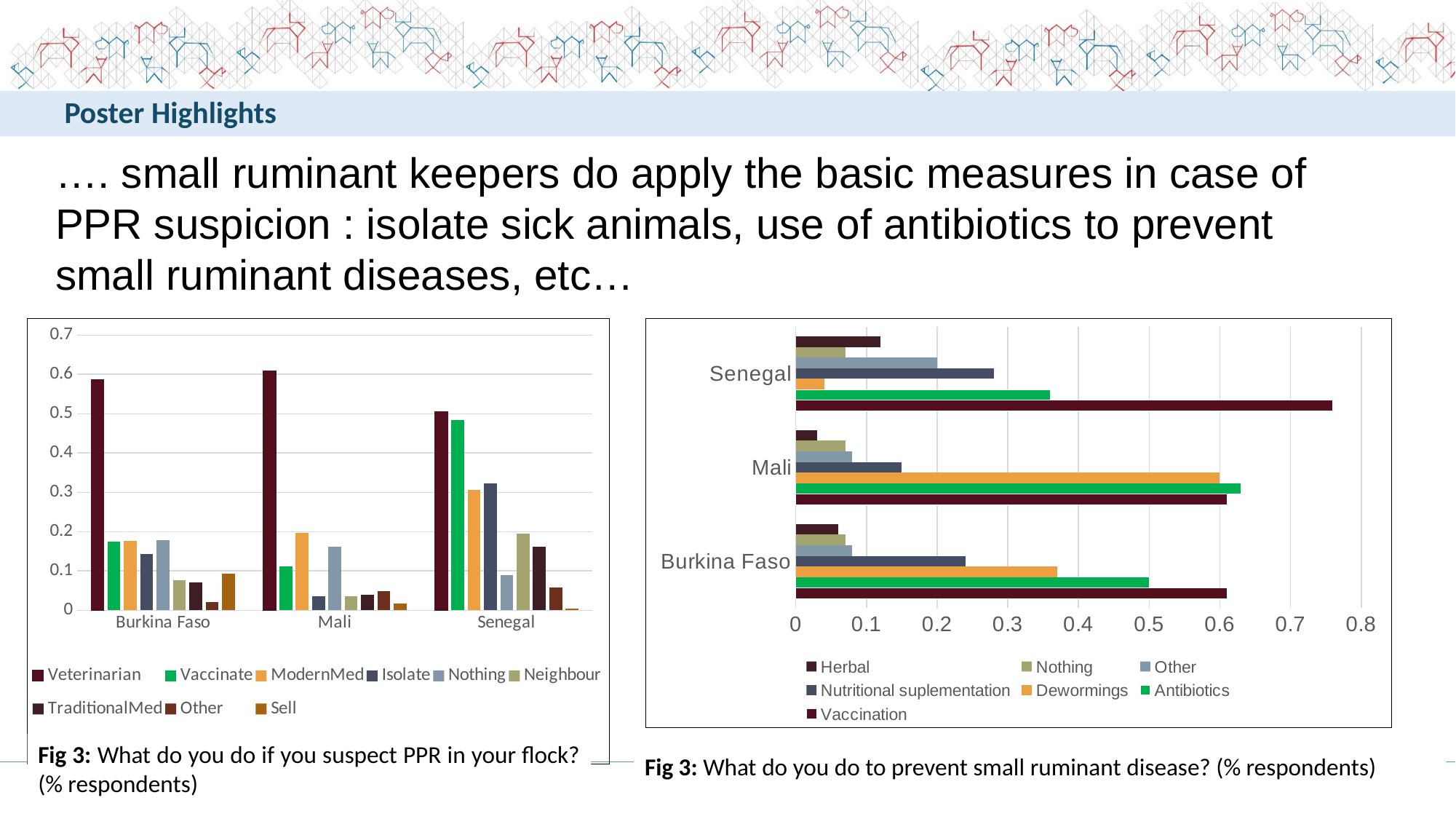
How many series does the legend of the right chart (What do you do to prevent small ruminant disease?) list? 7 In the right chart (What do you do to prevent small ruminant disease?), which country has the larger Dewormings value, Mali or Senegal? Mali In the left chart (What do you do if you suspect PPR in your flock?), is the Vaccinate value for Mali greater or less than 0.2? less In the left chart (What do you do if you suspect PPR in your flock?), which country has the larger Vaccinate value, Mali or Senegal? Senegal In the right chart (What do you do to prevent small ruminant disease?), is the Vaccination value for Senegal greater or less than 0.7? greater What kind of chart is the left chart (What do you do if you suspect PPR in your flock?)? bar chart How many countries are shown on the x axis of the left chart (What do you do if you suspect PPR in your flock?)? 3 What kind of chart is the right chart (What do you do to prevent small ruminant disease?)? bar chart In the left chart (What do you do if you suspect PPR in your flock?), is the Veterinarian value for Mali greater or less than 0.5? greater In the right chart (What do you do to prevent small ruminant disease?), which measure is highest for Senegal? Vaccination In the left chart (What do you do if you suspect PPR in your flock?), which response is highest for Senegal? Veterinarian How many series does the legend of the left chart (What do you do if you suspect PPR in your flock?) list? 9